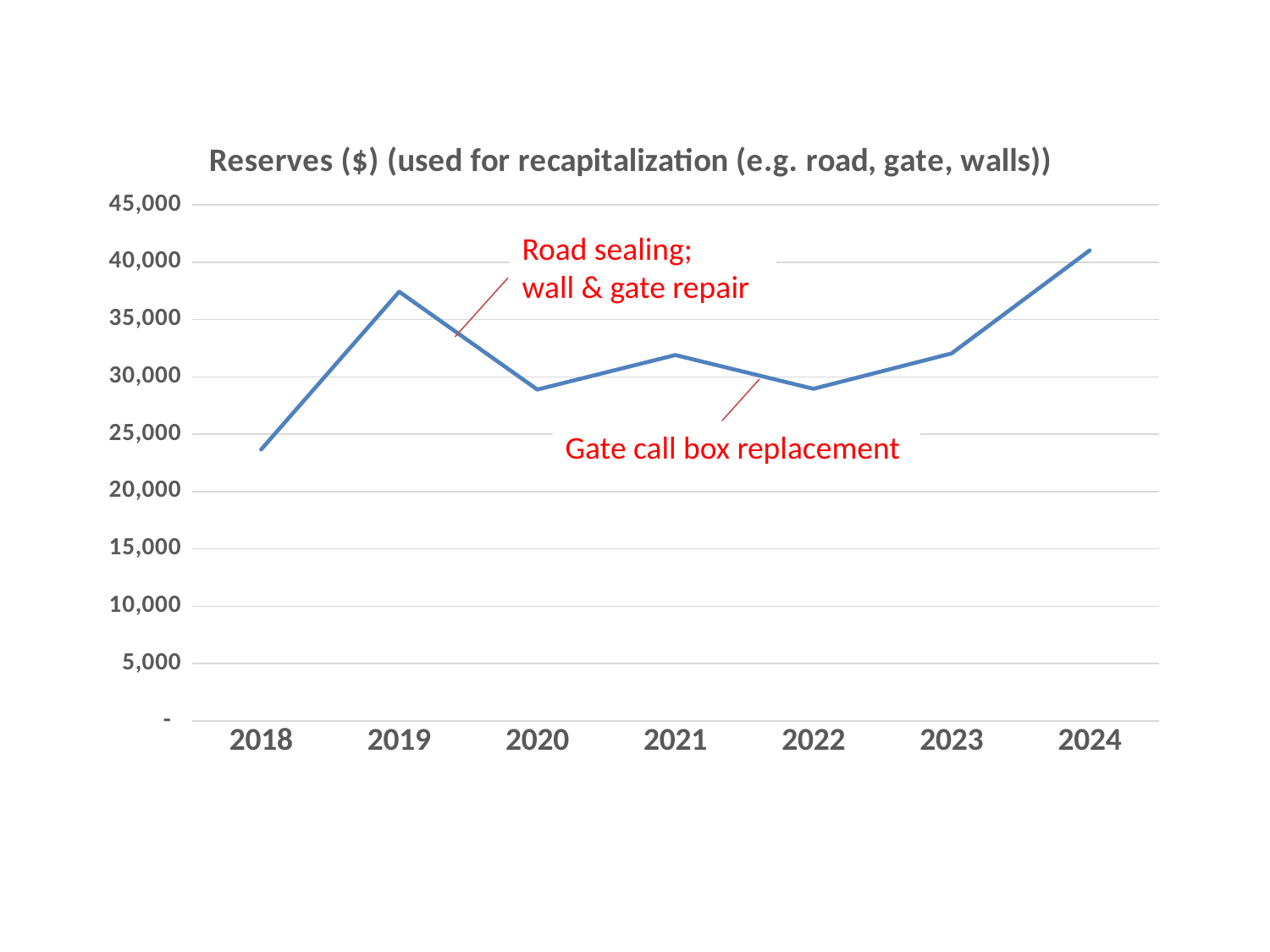
Is the reserves value for 2024 greater or less than 40,000? greater How many years are plotted on the x axis? 7 Which year has the highest reserves value? 2024 What event does the annotation near the 2021–2022 segment of the line describe? Gate call box replacement Which year has the lowest reserves value? 2018 Do the reserves rise or fall from 2022 to 2024? rise Which year has the larger reserves value, 2019 or 2020? 2019 Is the reserves value for 2018 greater or less than 25,000? less Is the reserves value for 2021 greater or less than 30,000? greater What is the title of the chart? Reserves ($) (used for recapitalization (e.g. road, gate, walls)) What kind of chart is shown on the slide? line chart